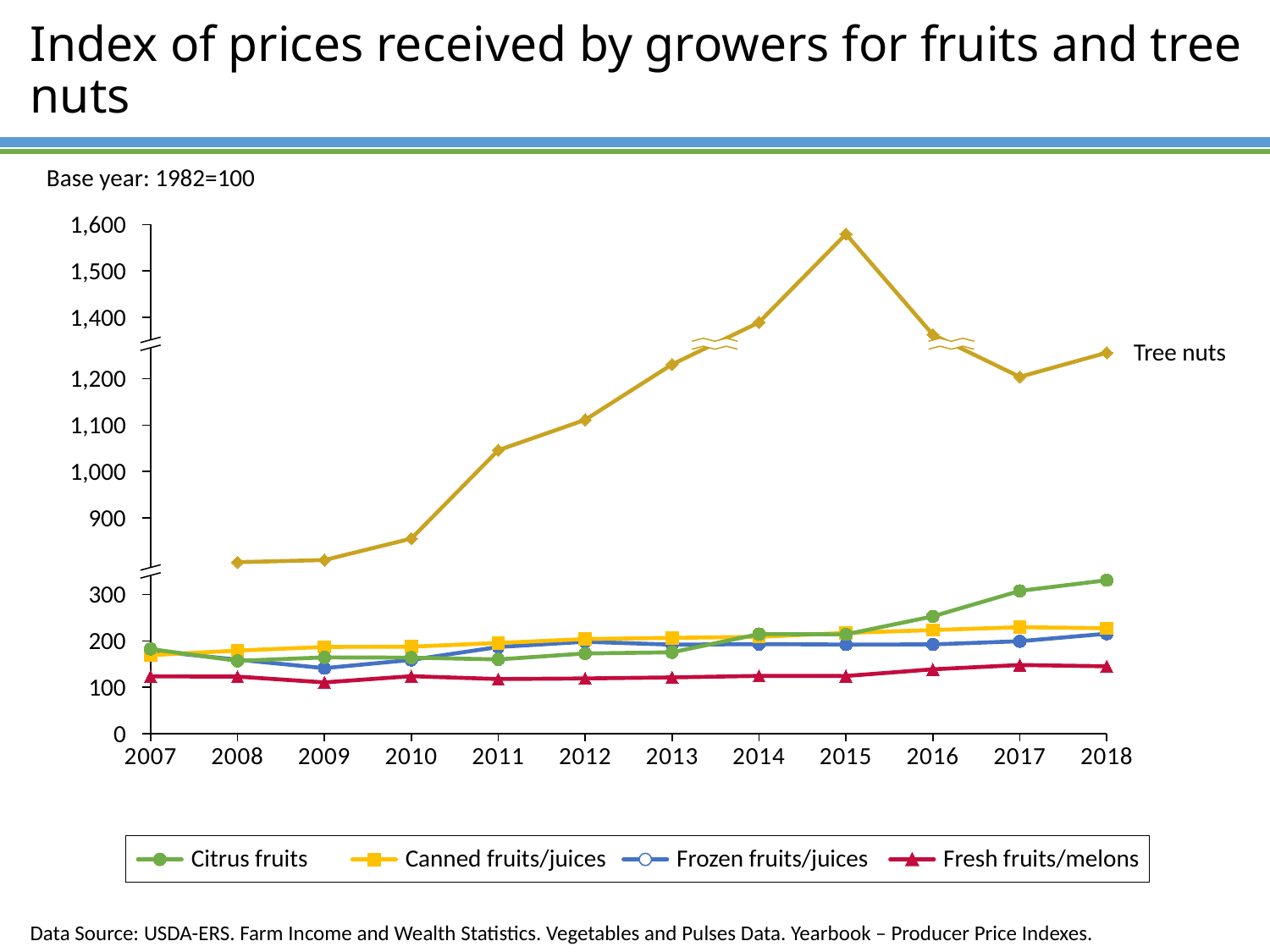
What kind of chart is shown on the slide? line chart Is the value for Citrus fruits in 2018 greater or less than 300? greater Which series has the lowest value in 2018? Fresh fruits/melons How many years are shown along the x axis? 12 In which year does the Tree nuts line reach its highest value? 2015 How many series does the legend list? 4 Is the value for Fresh fruits/melons in 2018 greater or less than 200? less Which series has the highest values across the chart? Tree nuts Is the value for Tree nuts in 2015 greater or less than 1,500? greater What base year is stated for the index on the slide? 1982=100 Does the Tree nuts line rise or fall between 2007 and 2015? rise Which is larger: the Tree nuts value in 2015 or in 2018? 2015